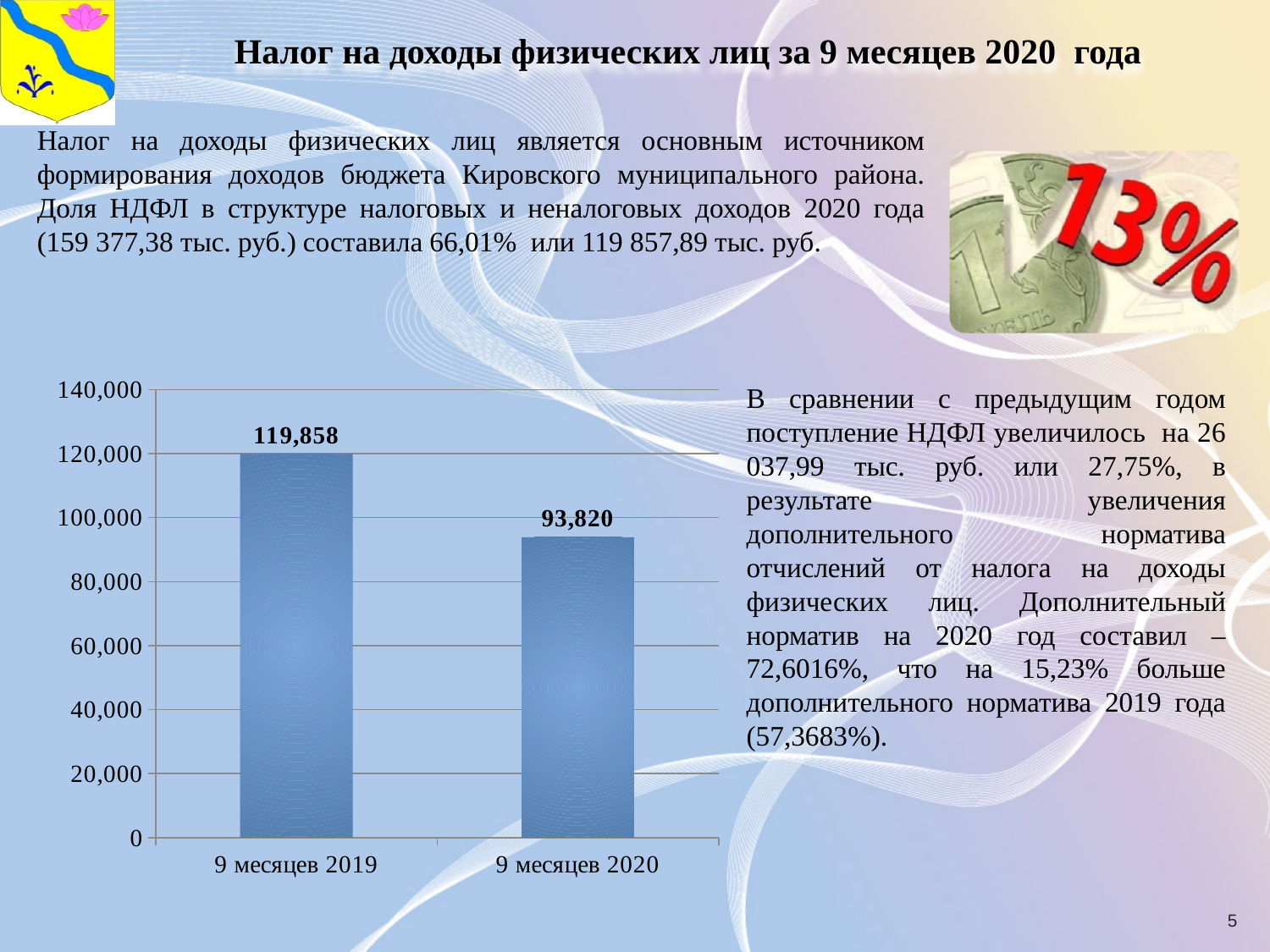
Is the value for 9 месяцев 2019 greater or less than 100,000? greater Which category has the lowest value? 9 месяцев 2020 What kind of chart is shown on the slide? bar chart Which category has the highest value? 9 месяцев 2019 How many categories are shown on the chart? 2 Is the value for 9 месяцев 2020 greater or less than 100,000? less Do the values rise or fall from 9 месяцев 2019 to 9 месяцев 2020? fall What is the value shown for 9 месяцев 2020? 93,820 What is the difference between the values for 9 месяцев 2019 and 9 месяцев 2020? 26,038 What is the highest value marked on the vertical axis of the chart? 140,000 What is the value shown for 9 месяцев 2019? 119,858 Which is larger, the value for 9 месяцев 2019 or for 9 месяцев 2020? 9 месяцев 2019